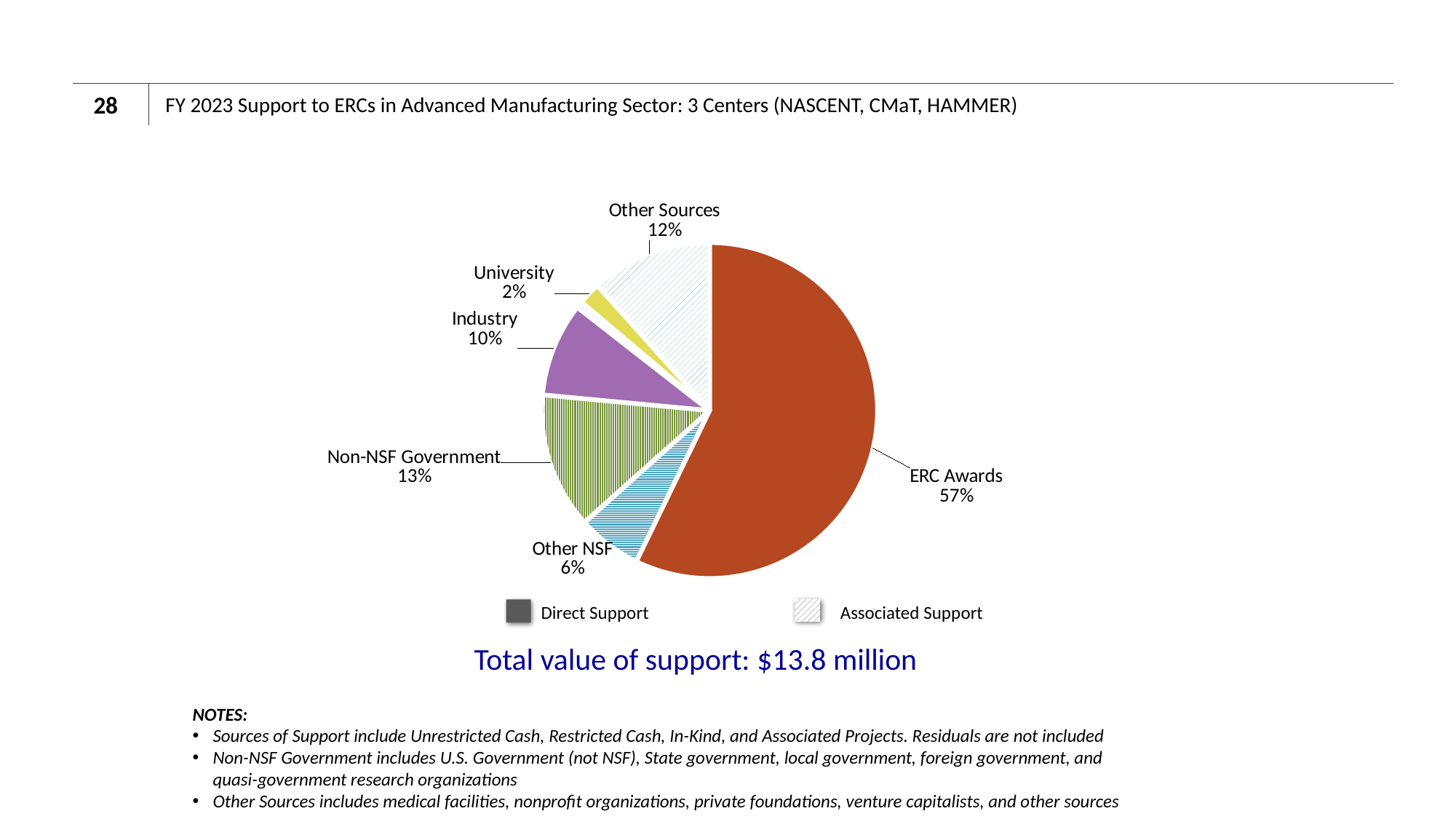
What is the value shown for Non-NSF Government? 13% What share of the pie does ERC Awards represent? 57% Which category has the smallest slice of the pie? University What is the value shown for Industry? 10% What percentage is shown for Other Sources? 12% What is the difference in percentage points between ERC Awards and Non-NSF Government? 44 Which is larger, the Industry slice or the Other NSF slice? Industry How many categories are shown in the pie chart? 6 What are the two legend entries shown below the pie chart? Direct Support and Associated Support What is the total value of support stated below the chart? $13.8 million Which category has the largest slice of the pie? ERC Awards What kind of chart is shown on the slide? Pie chart